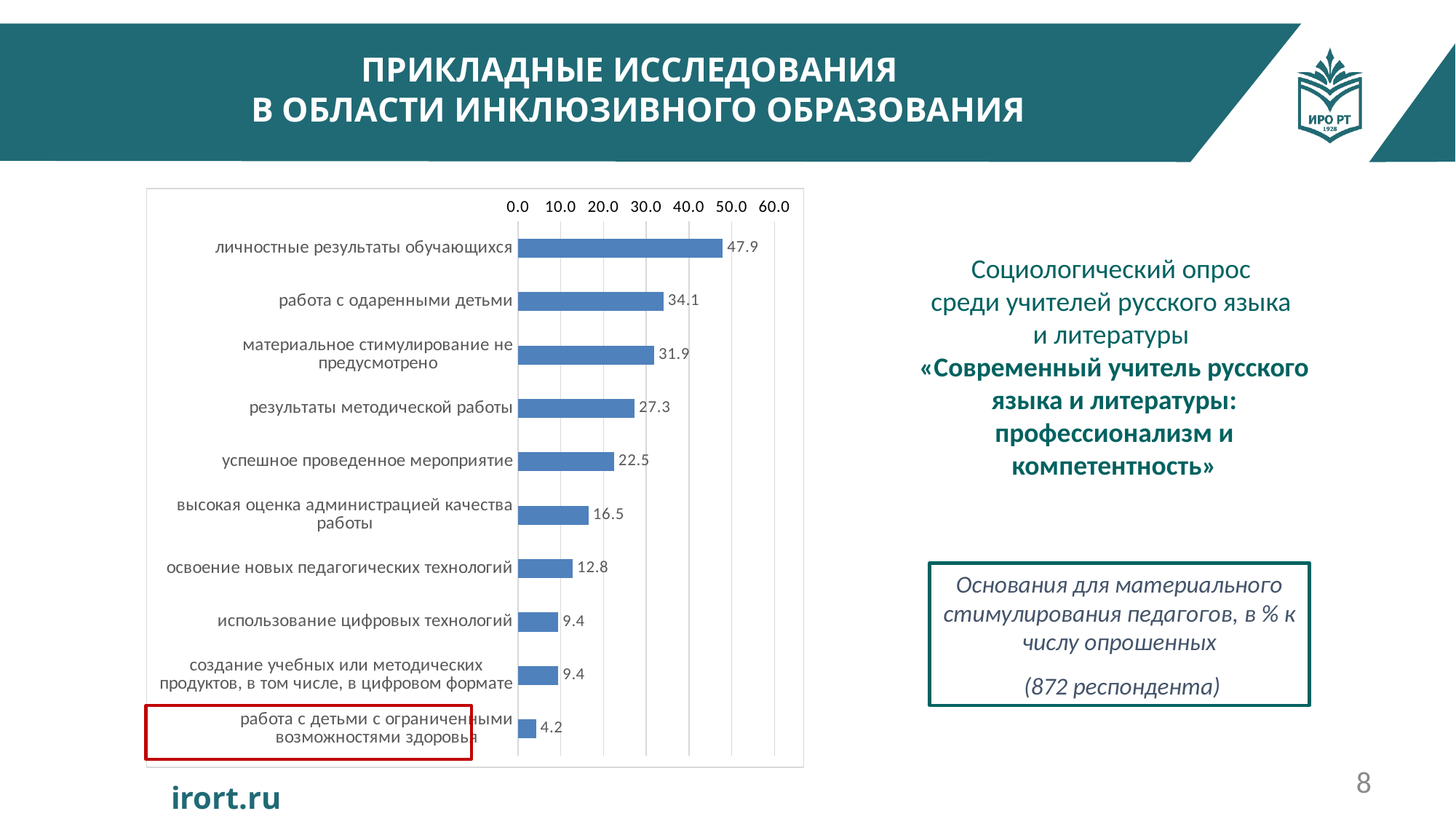
What is the difference between the highest and lowest values in the chart? 43.7 Which category has the lowest value? работа с детьми с ограниченными возможностями здоровья Which category is highlighted with a red box on the slide? работа с детьми с ограниченными возможностями здоровья Which is larger: the value for «результаты методической работы» or for «высокая оценка администрацией качества работы»? результаты методической работы How many categories are shown in the chart? 10 What kind of chart is shown on the slide? bar chart Is the value for «освоение новых педагогических технологий» greater or less than 20.0? less What is the difference between the values for «работа с одаренными детьми» and «материальное стимулирование не предусмотрено»? 2.2 What is the value for «работа с детьми с ограниченными возможностями здоровья»? 4.2 What is the value for «успешное проведенное мероприятие»? 22.5 What is the value for «личностные результаты обучающихся»? 47.9 Which category has the highest value? личностные результаты обучающихся